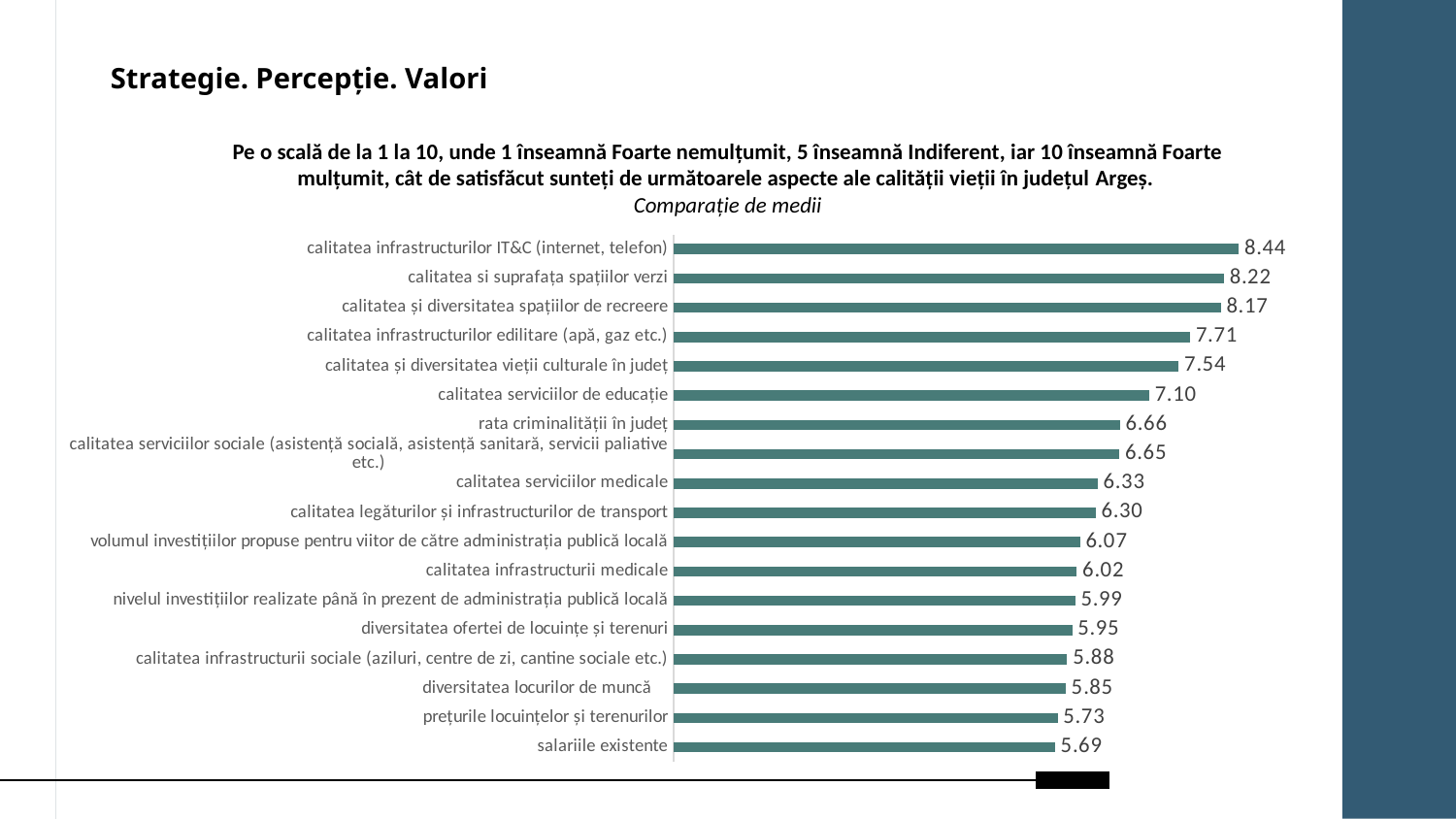
Which aspect has the lowest average satisfaction score? salariile existente How many aspects (categories) are shown on the chart? 18 What is the difference between the highest and lowest scores on the chart? 2.75 What is the value shown for 'calitatea serviciilor de educație'? 7.10 What is the difference between the scores for 'calitatea si suprafața spațiilor verzi' and 'calitatea și diversitatea spațiilor de recreere'? 0.05 What is the value shown for 'salariile existente'? 5.69 Which has a higher score: 'calitatea serviciilor medicale' or 'calitatea legăturilor și infrastructurilor de transport'? calitatea serviciilor medicale What is the value shown for 'calitatea infrastructurii medicale'? 6.02 What is the subtitle shown in italics below the chart's question text? Comparație de medii Which aspect has the highest average satisfaction score? calitatea infrastructurilor IT&C (internet, telefon) What is the average satisfaction score for 'calitatea infrastructurilor IT&C (internet, telefon)'? 8.44 What type of chart is shown on the slide? bar chart